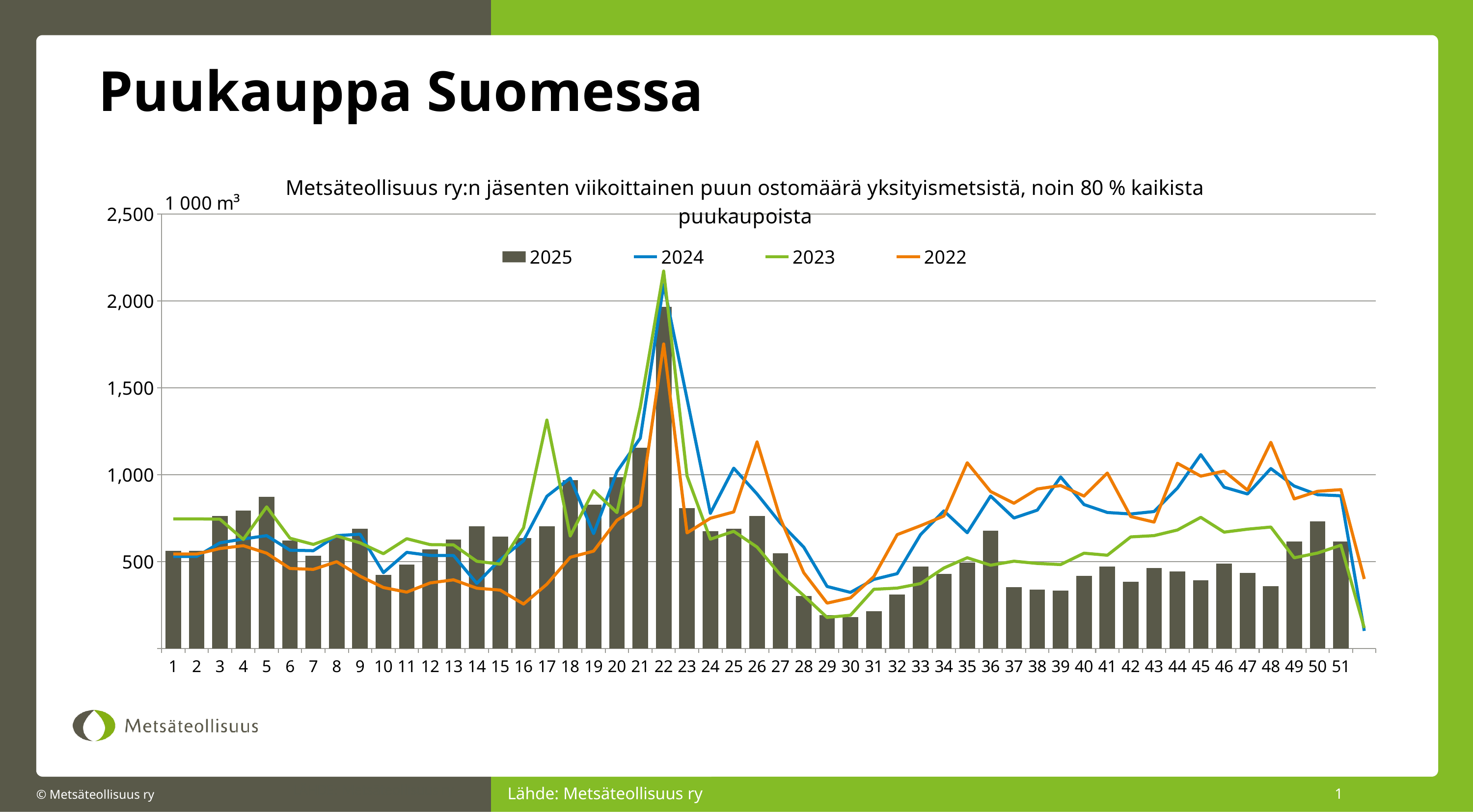
What kind of chart is shown on the slide? Combined bar and line chart Is the 2023 value for week 22 greater or less than 2,000? greater Is the 2025 value for week 29 greater or less than 500? less How many series does the chart legend list? 4 What unit is shown on the vertical axis? 1 000 m³ Do the 2025 bars rise or fall from week 22 to week 29? fall Which is larger for 2025: the value for week 5 or the value for week 10? week 5 Which series is drawn as bars? 2025 Is the 2022 value for week 22 greater or less than 1,500? greater How many week labels are shown on the x axis? 51 In which week is the 2025 bar highest? 22